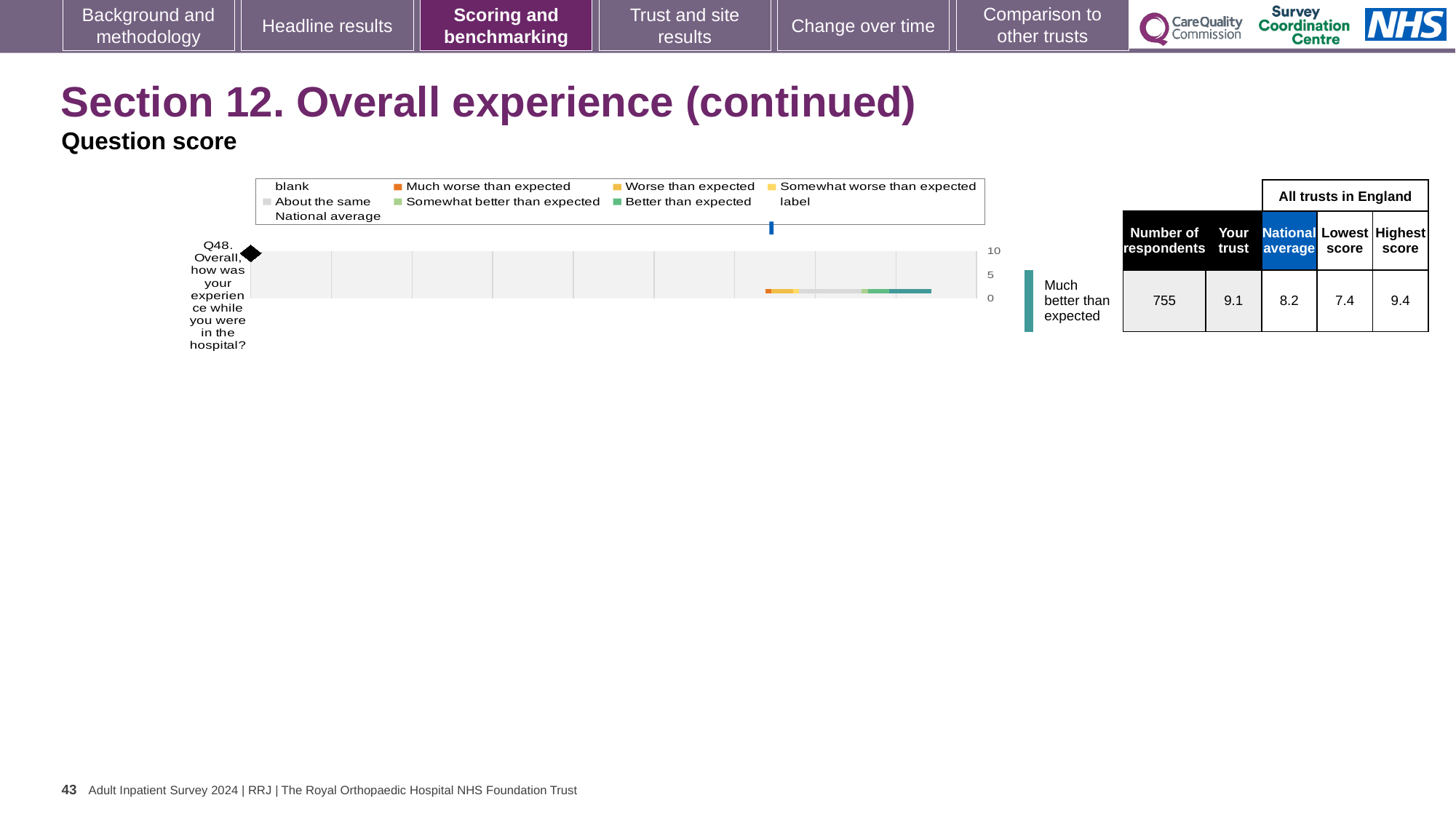
Which is larger for Q48, the trust's score or the national average? Your trust What is the highest score among all trusts in England for Q48? 9.4 What is the national average score for Q48? 8.2 What is the lowest score among all trusts in England for Q48? 7.4 What is the difference between the highest and lowest scores among all trusts in England for Q48? 2.0 How many respondents answered Q48? 755 What is the 'Your trust' score for Q48? 9.1 How many survey questions are plotted in the chart? 1 Which benchmarking category is the trust's Q48 result placed in? Much better than expected Which question is plotted in the chart? Q48. Overall, how was your experience while you were in the hospital? What kind of chart is shown on the slide? bar chart What is the difference between the trust's score and the national average for Q48? 0.9